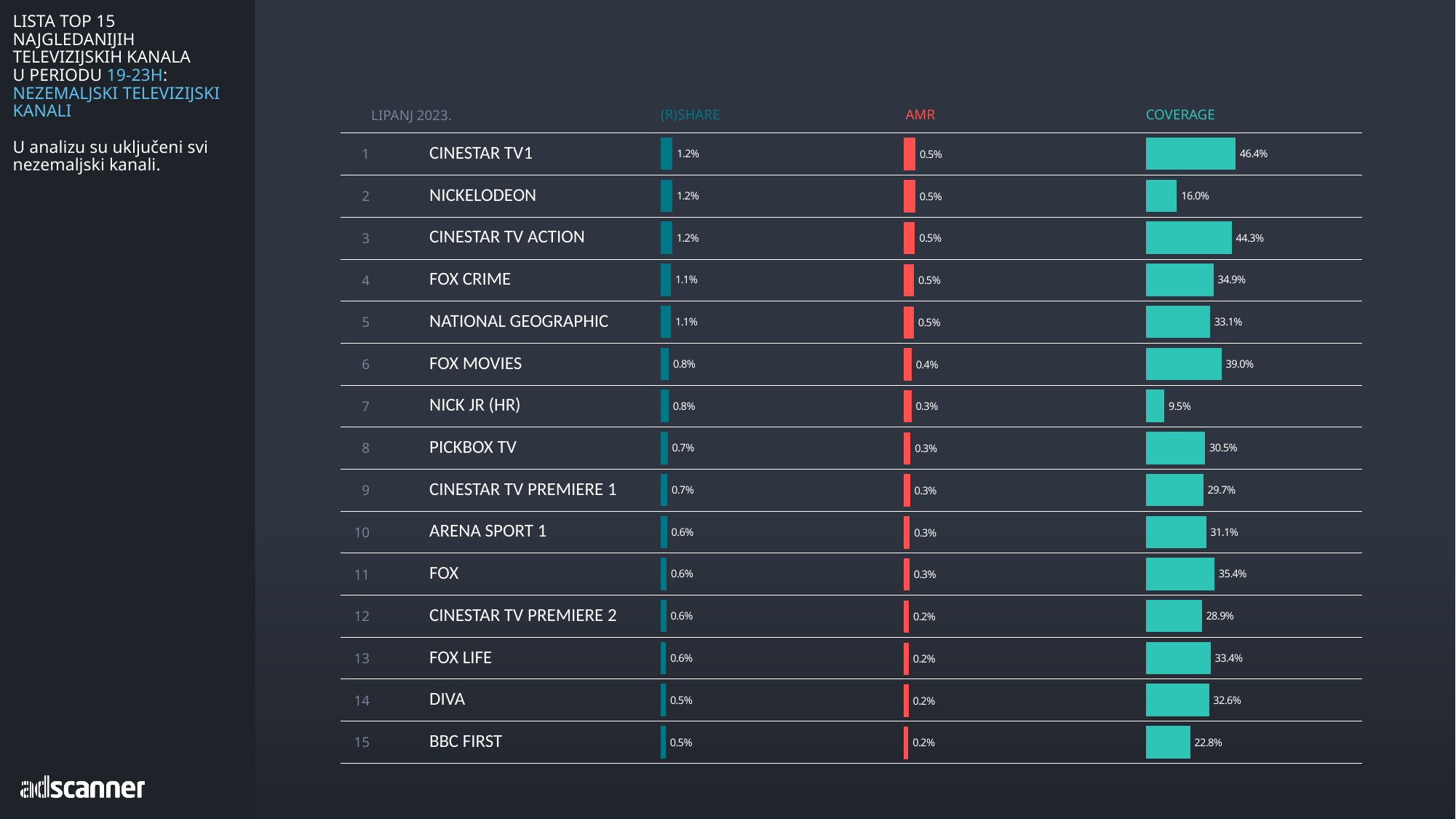
Which channel has the highest COVERAGE value? CINESTAR TV1 What is the COVERAGE value for BBC FIRST? 22.8% Which has the larger COVERAGE value, FOX MOVIES or FOX CRIME? FOX MOVIES Which channel has the lowest COVERAGE value? NICK JR (HR) What is the difference in COVERAGE between CINESTAR TV1 and NICKELODEON? 30.4 percentage points What is the (R)SHARE value for FOX CRIME? 1.1% What kind of chart is used to show the COVERAGE values? Bar chart What is the AMR value for NICK JR (HR)? 0.3% What is the COVERAGE value for CINESTAR TV1? 46.4% What is the (R)SHARE value for DIVA? 0.5% Which month and year does the chart refer to? LIPANJ 2023. How many channels are listed in the chart? 15